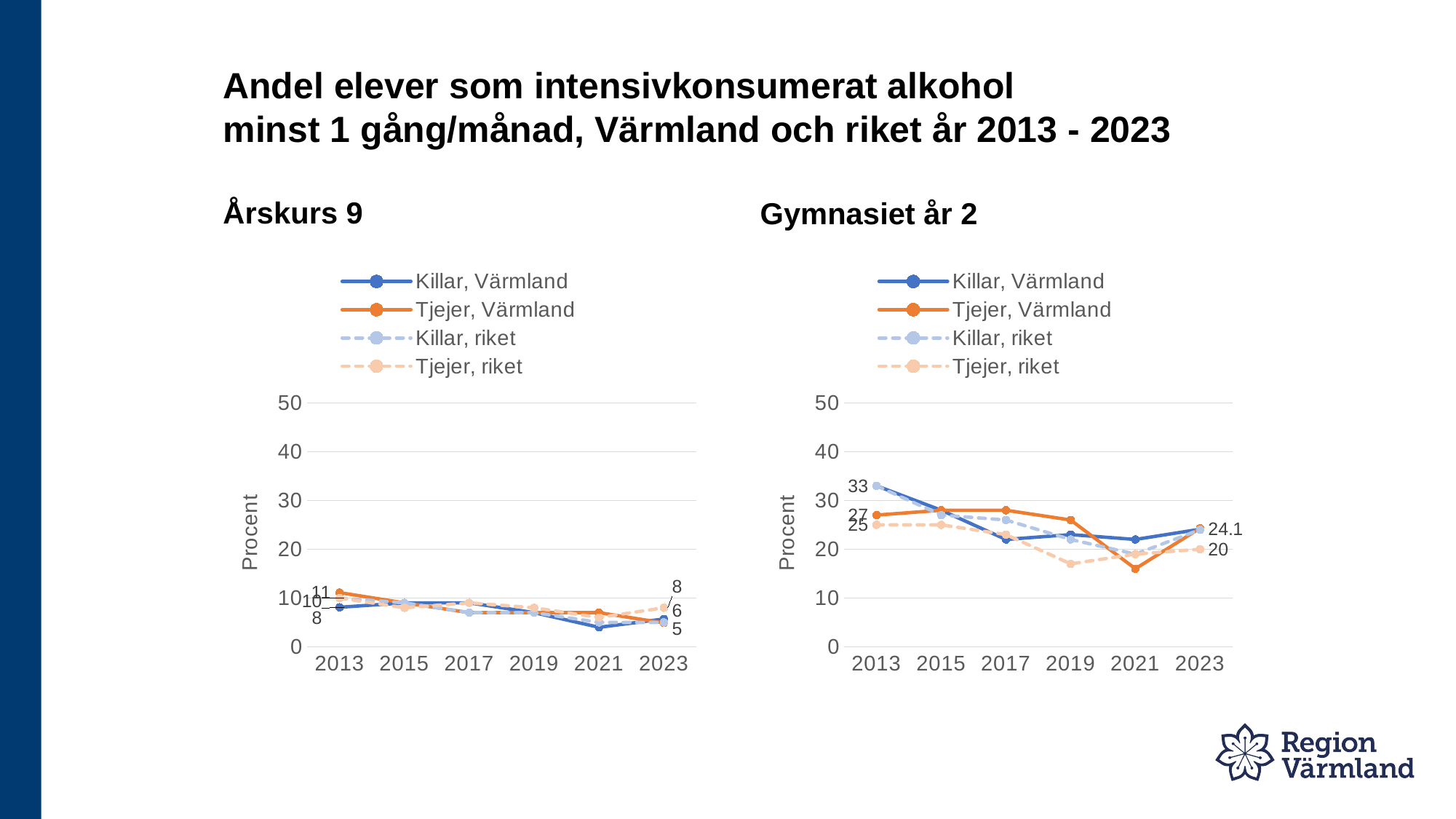
In the Gymnasiet år 2 chart, what is the value for Tjejer, Värmland in 2013? 27 In the Gymnasiet år 2 chart, what is the difference between Killar, Värmland and Tjejer, riket in 2013? 8 In the Gymnasiet år 2 chart, which is larger in 2013: Killar, Värmland or Tjejer, Värmland? Killar, Värmland In the Gymnasiet år 2 chart, what is the value for Tjejer, riket in 2023? 20 How many series does the legend of the Gymnasiet år 2 chart list? 4 In the Årskurs 9 chart, what is the value for Killar, Värmland in 2013? 8 How many years are shown on the x axis of the Årskurs 9 chart? 6 In the Gymnasiet år 2 chart, is the value for Tjejer, Värmland in 2021 greater or less than 20? less In the Gymnasiet år 2 chart, what is the value for Tjejer, riket in 2013? 25 What kind of chart is the Årskurs 9 chart? line chart What is the label on the y axis of the Gymnasiet år 2 chart? Procent In the Gymnasiet år 2 chart, what is the value for Killar, Värmland in 2013? 33